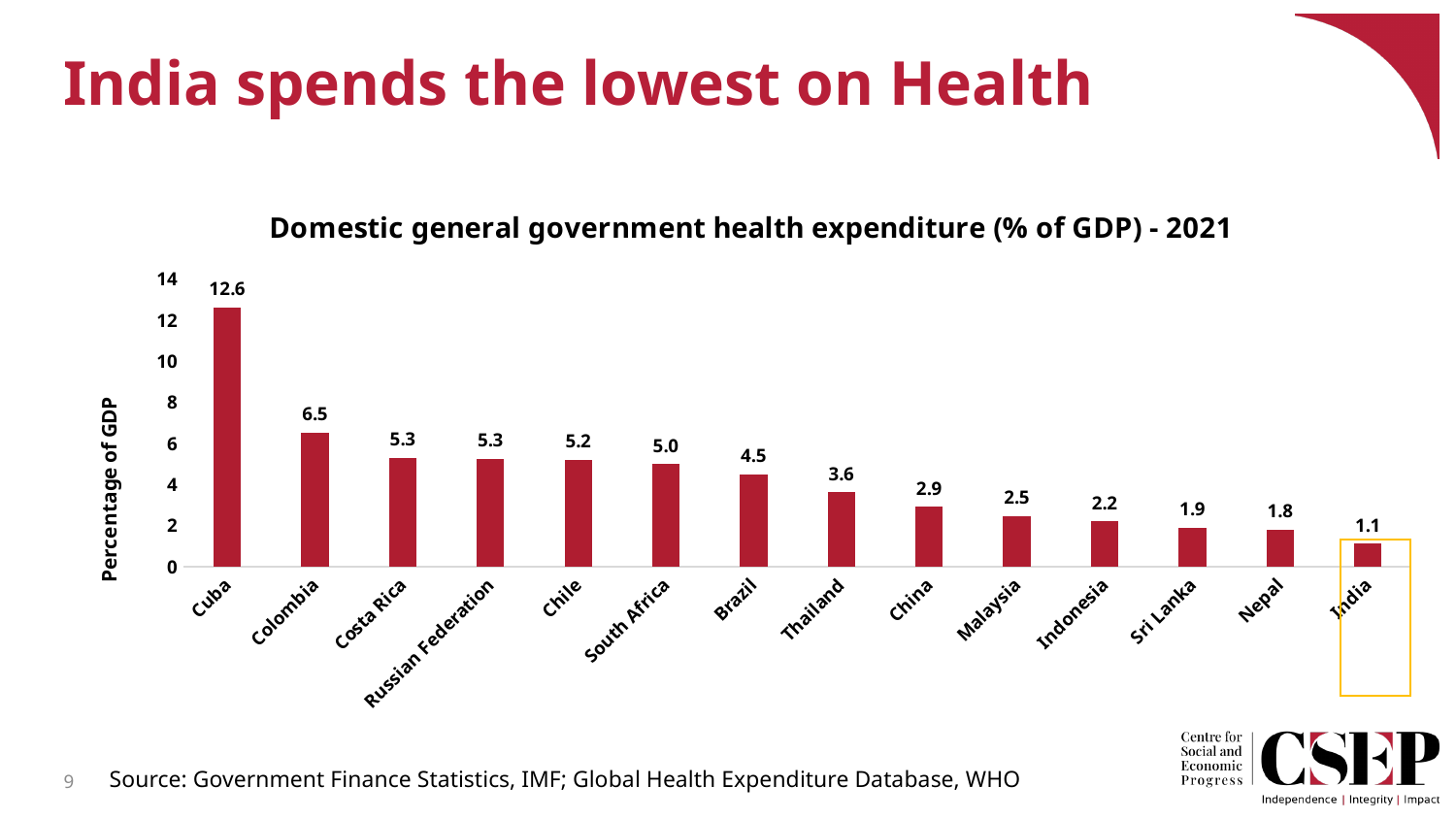
Which country has the lowest government health expenditure as a percentage of GDP? India What is the value shown for India? 1.1 What type of chart is shown on the slide? Bar chart What is the domestic general government health expenditure (% of GDP) for Cuba? 12.6 Which has a higher value, Brazil or Malaysia? Brazil Which country has the highest government health expenditure as a percentage of GDP? Cuba What is the title of the chart? Domestic general government health expenditure (% of GDP) - 2021 What is the difference between the values for China and India? 1.8 What is the value shown for Thailand? 3.6 How many countries are shown in the chart? 14 Do the values rise or fall moving from left to right along the x axis? Fall What is the difference between the values for Cuba and Colombia? 6.1